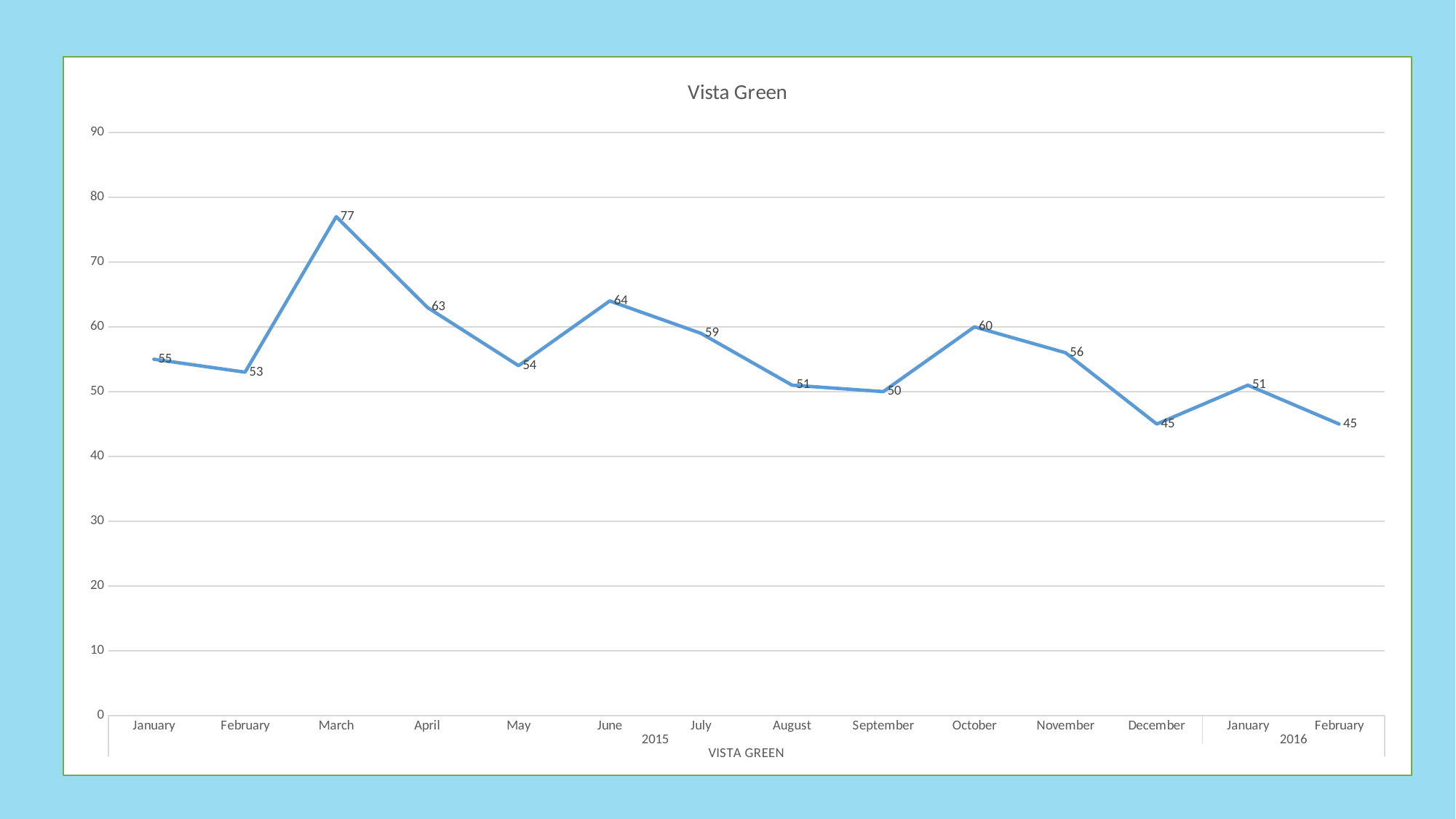
Which is larger, the value for June 2015 or the value for July 2015? June 2015 What is the difference between the values for January 2015 and January 2016? 4 What kind of chart is shown? line chart What is the value for February 2016? 45 Does the value rise or fall from February 2015 to March 2015? rise What is the title of the chart? Vista Green What is the lowest value shown on the chart? 45 How many data points are plotted on the chart? 14 Which month has the highest value? March 2015 What is the difference between the values for March 2015 and April 2015? 14 What is the value for October 2015? 60 What is the value for March 2015? 77